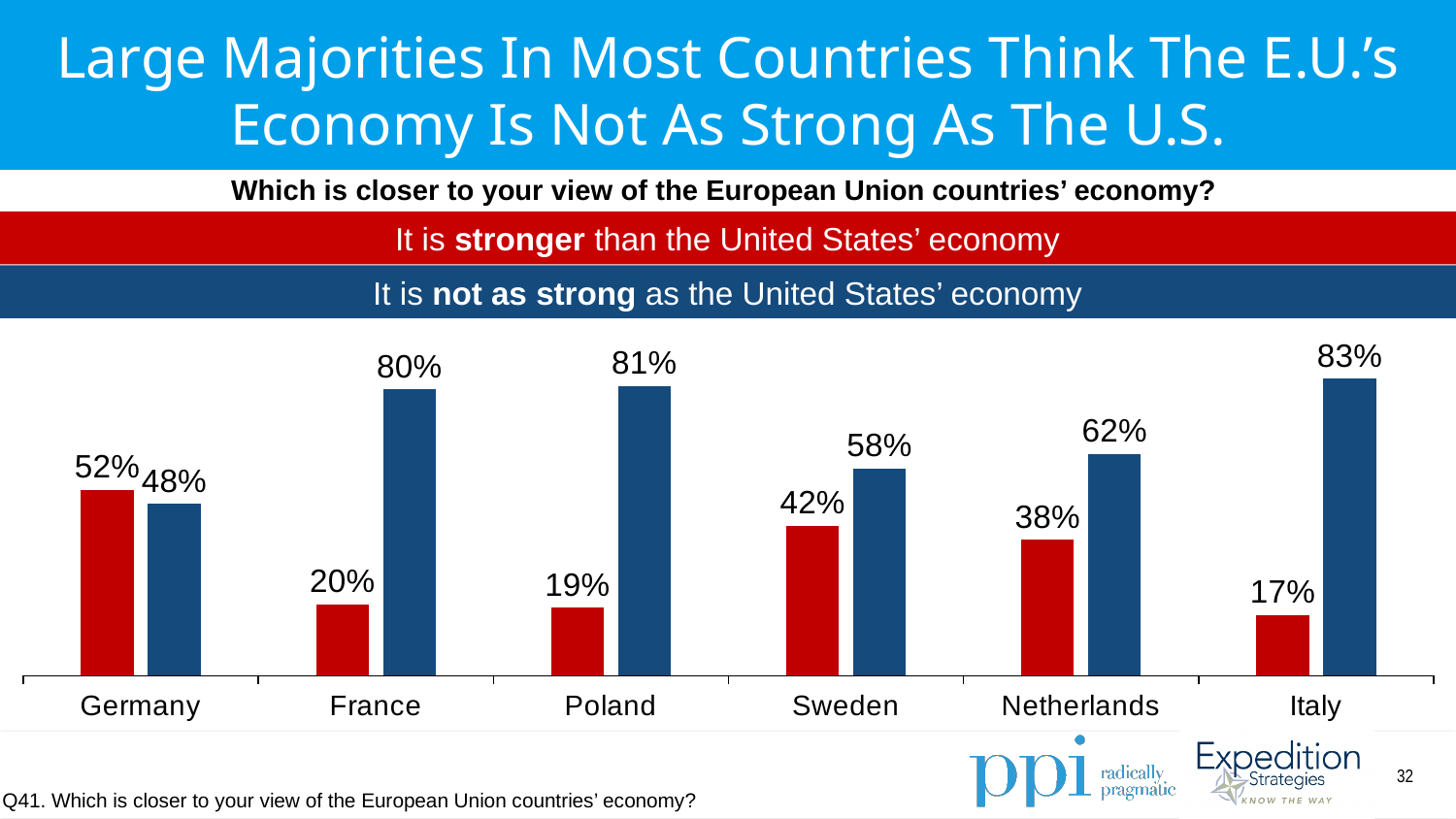
What percentage of respondents in Germany say the E.U. economy is stronger than the United States' economy? 52% What is the difference between the 'not as strong' and 'stronger' percentages for France? 60 percentage points Which country has the highest share saying the E.U. economy is not as strong as the United States' economy? Italy How many countries are shown on the chart? 6 Which is larger for the Netherlands: the share saying 'stronger' or the share saying 'not as strong'? Not as strong Which country has the lowest share saying the E.U. economy is stronger than the United States' economy? Italy What type of chart is shown on the slide? Bar chart How many response options (series) does the chart show? 2 What percentage of respondents in Italy say the E.U. economy is not as strong as the United States' economy? 83% What colour are the bars representing 'It is not as strong as the United States' economy'? Blue What percentage of respondents in Sweden say the E.U. economy is stronger than the United States' economy? 42% Which country is the only one where more respondents say the E.U. economy is stronger than say it is not as strong? Germany